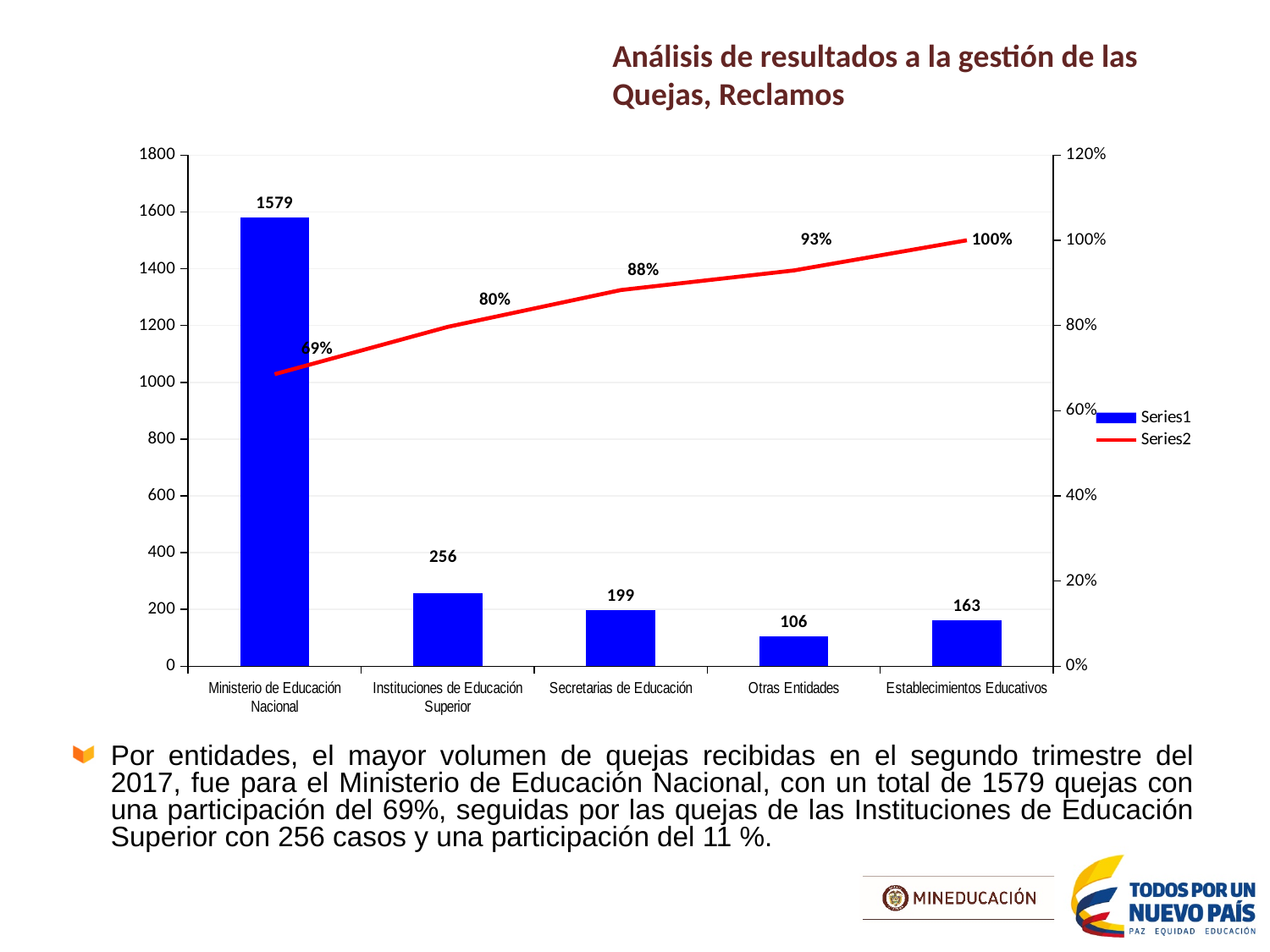
How many categories are shown on the x axis? 5 Which category has the highest Series1 value? Ministerio de Educación Nacional What colour are the Series1 bars? Blue Does the Series2 line rise or fall from left to right across the categories? rise What is the Series2 percentage at Secretarias de Educación? 88% What is the difference between the Series1 values for Instituciones de Educación Superior and Secretarias de Educación? 57 What is the Series2 percentage at Establecimientos Educativos? 100% Which category has the lowest Series1 value? Otras Entidades What is the Series1 value for Ministerio de Educación Nacional? 1579 Which has a larger Series1 value, Establecimientos Educativos or Otras Entidades? Establecimientos Educativos What is the Series1 value for Otras Entidades? 106 How many series does the legend list? 2